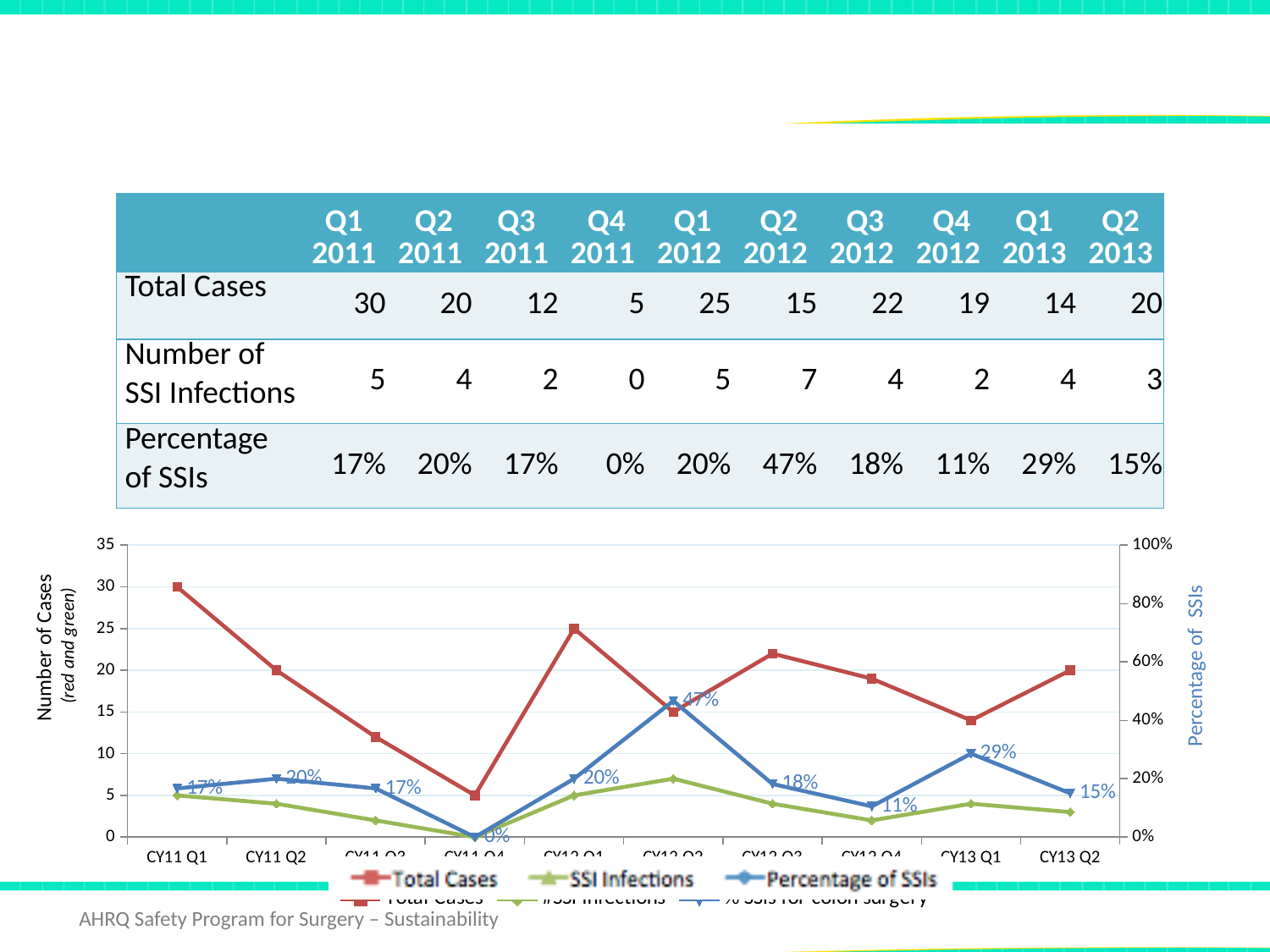
How many quarters are plotted along the x axis of the chart? 10 What is the label on the right-hand vertical axis of the chart? Percentage of SSIs By how many percentage points does the Percentage of SSIs drop from CY12 Q2 to CY12 Q3? 29 percentage points Which quarter has the lowest Percentage of SSIs on the chart? CY11 Q4 What kind of chart is shown on the slide? line chart Is the Total Cases value for CY11 Q1 greater or less than 25? greater Which quarter has the highest Percentage of SSIs on the chart? CY12 Q2 How many series does the chart's legend list? 3 Which has the higher Percentage of SSIs, CY11 Q2 or CY13 Q2? CY11 Q2 What is the Percentage of SSIs for CY13 Q1 on the chart? 29% What is the Percentage of SSIs for CY12 Q2 on the chart? 47% Do Total Cases rise or fall from CY11 Q1 to CY11 Q4? fall